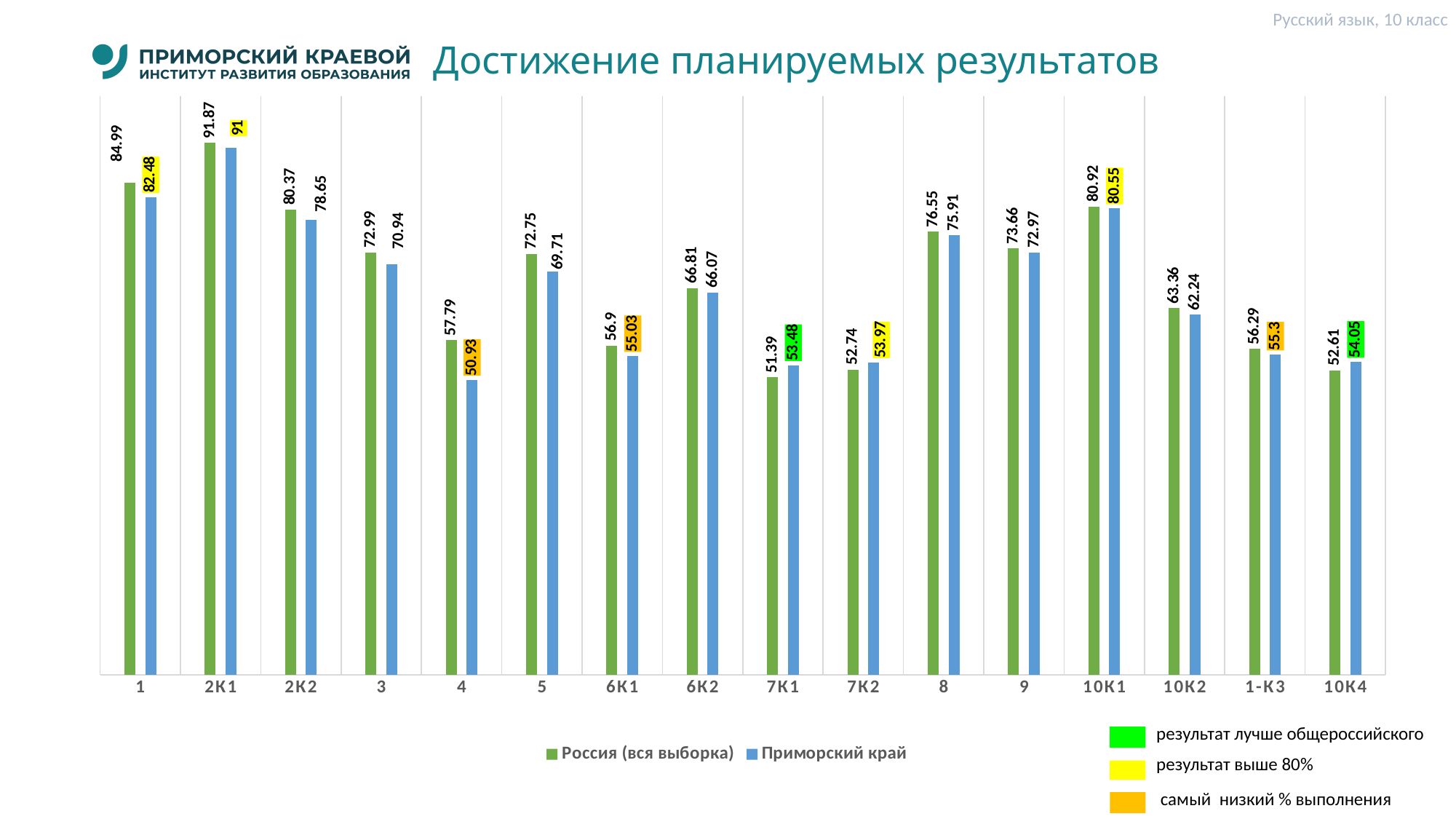
Which category has the highest value for Приморский край? 2К1 What is the value for Приморский край for category 4? 50.93 Which category has the lowest value for Приморский край? 4 Which category has the lowest value for Россия (вся выборка)? 7К1 What is the difference between the Россия (вся выборка) and Приморский край values for category 4? 6.86 How many series does the chart legend list? 2 What is the value for Россия (вся выборка) for category 10К1? 80.92 What is the value for Приморский край for category 7К1? 53.48 How many categories are shown on the x axis? 16 For category 10К4, which series has the larger value: Россия (вся выборка) or Приморский край? Приморский край What is the title of the chart on the slide? Достижение планируемых результатов What type of chart is shown on the slide? Bar chart